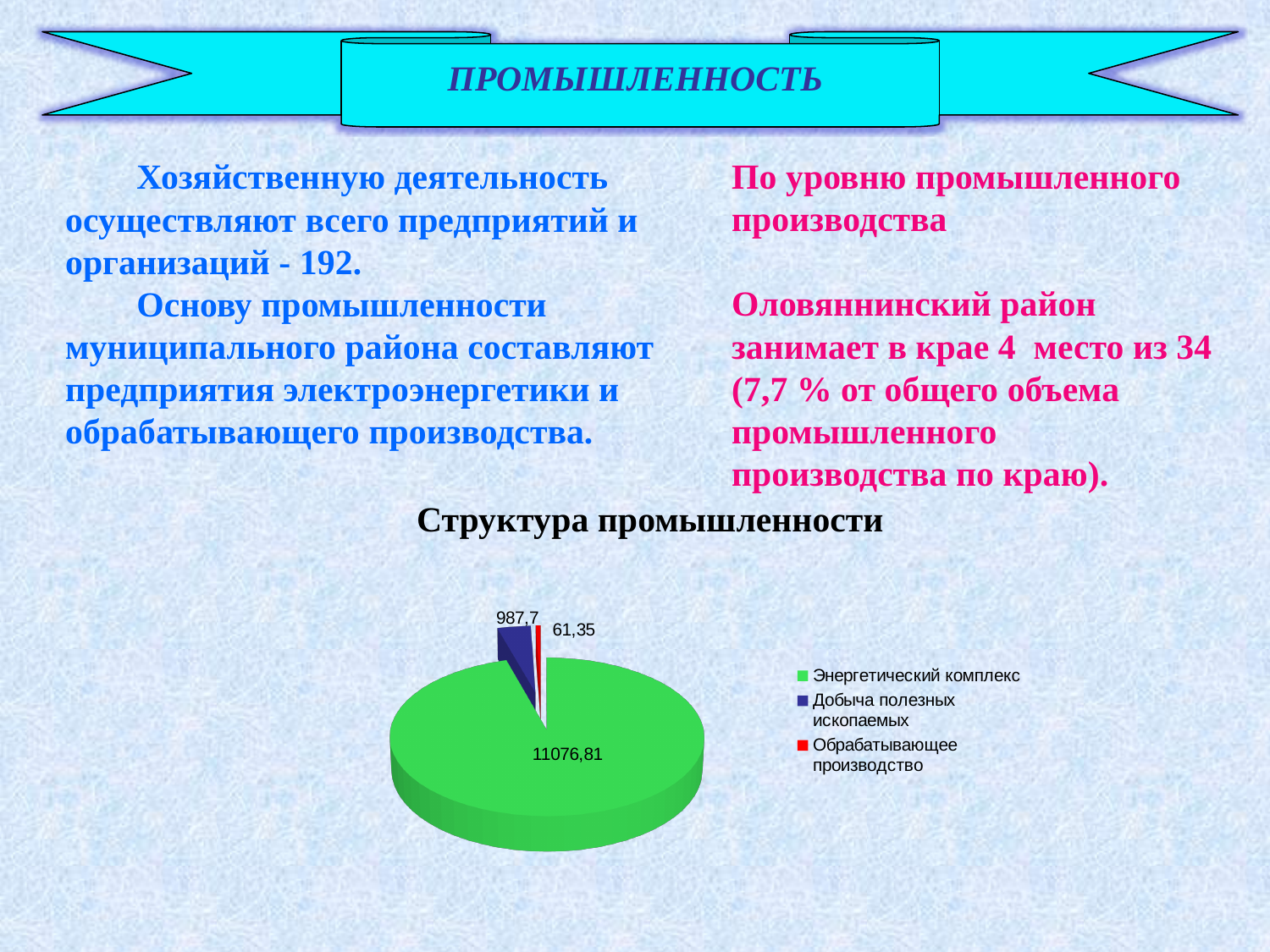
What type of chart is shown under the heading «Структура промышленности»? Pie chart What is the value for «Добыча полезных ископаемых» in the pie chart? 987,7 What is the value for «Энергетический комплекс» in the pie chart? 11076,81 What is the difference between the values for «Добыча полезных ископаемых» and «Обрабатывающее производство»? 926,35 What is the difference between the values for «Энергетический комплекс» and «Добыча полезных ископаемых»? 10089,11 Which category has the smallest slice in the pie chart? Обрабатывающее производство What colour is the slice for «Обрабатывающее производство» in the pie chart? Red What is the value for «Обрабатывающее производство» in the pie chart? 61,35 Which category has the largest slice in the pie chart? Энергетический комплекс Which is larger in the pie chart: «Добыча полезных ископаемых» or «Обрабатывающее производство»? Добыча полезных ископаемых What is the total of all three values in the pie chart? 12125,86 How many categories does the pie chart show? 3